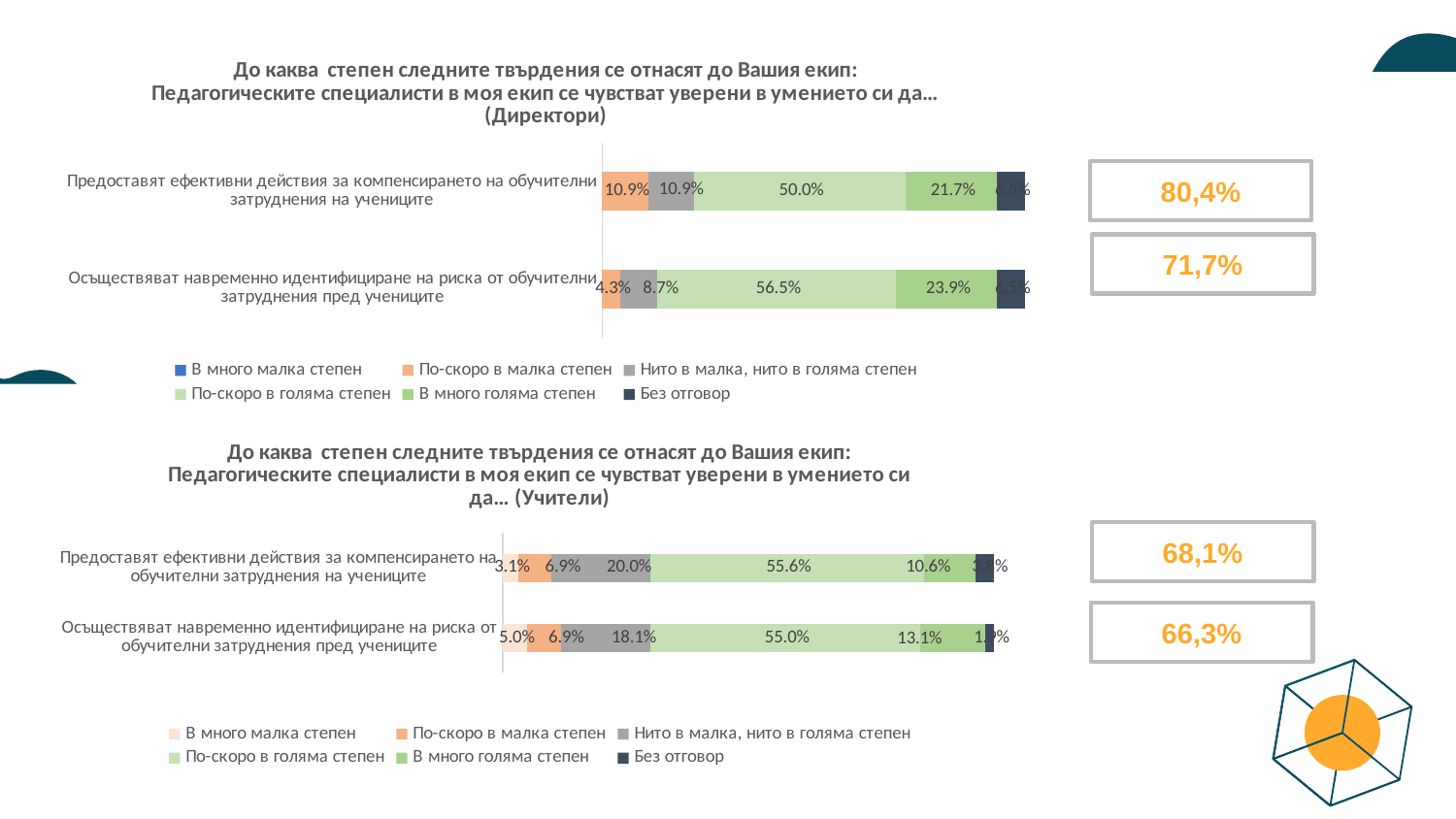
How many series does the legend of the top chart (Директори) list? 6 In the top chart (Директори), which statement has the larger value for 'По-скоро в голяма степен'? Осъществяват навременно идентифициране на риска от обучителни затруднения пред учениците What kind of chart is the top chart (Директори)? Stacked bar chart In the bottom chart (Учители), what is the difference between the 'В много голяма степен' values of the two statements? 2.5% In the top chart (Директори), what is the difference between the 'По-скоро в голяма степен' values of the two statements? 6.5% In the top chart (Директори), what is the value of 'По-скоро в малка степен' for 'Осъществяват навременно идентифициране на риска от обучителни затруднения пред учениците'? 4.3% In the top chart (Директори), what is the value of 'По-скоро в голяма степен' for 'Предоставят ефективни действия за компенсирането на обучителни затруднения на учениците'? 50.0% In the bottom chart (Учители), what is the value of 'В много голяма степен' for 'Осъществяват навременно идентифициране на риска от обучителни затруднения пред учениците'? 13.1% How many statements (categories) are plotted in the bottom chart (Учители)? 2 In the bottom chart (Учители), which response category has the largest share for 'Предоставят ефективни действия за компенсирането на обучителни затруднения на учениците'? По-скоро в голяма степен In the top chart (Директори), what is the value of 'В много голяма степен' for 'Осъществяват навременно идентифициране на риска от обучителни затруднения пред учениците'? 23.9% In the bottom chart (Учители), what is the value of 'Нито в малка, нито в голяма степен' for 'Предоставят ефективни действия за компенсирането на обучителни затруднения на учениците'? 20.0%